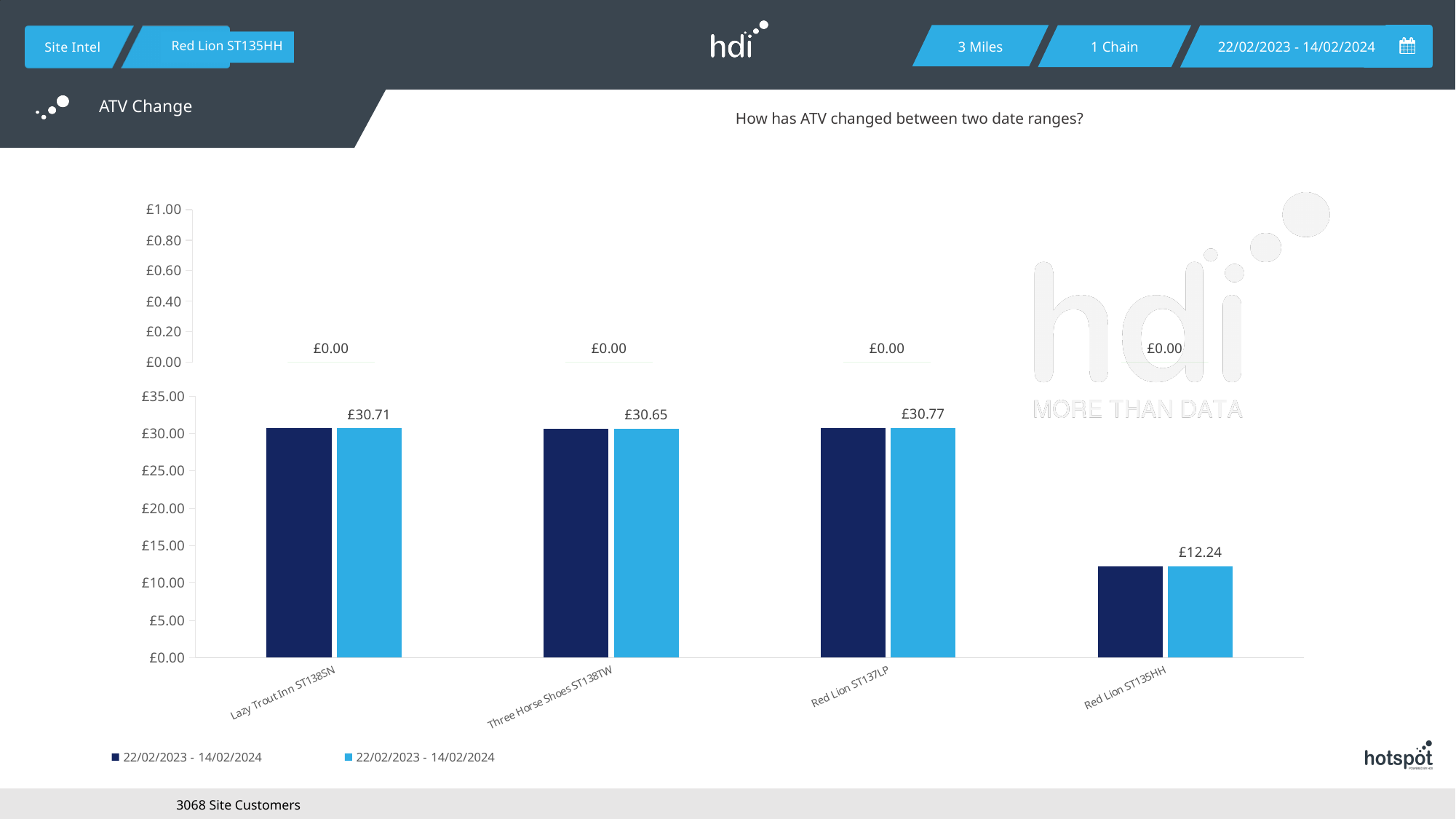
What is the ATV value labelled for Lazy Trout Inn ST138SN? £30.71 Which has a larger labelled ATV value, Lazy Trout Inn ST138SN or Red Lion ST135HH? Lazy Trout Inn ST138SN Which site has the highest labelled ATV value? Red Lion ST137LP How many series does the legend list? 2 What is the ATV value labelled for Red Lion ST135HH? £12.24 What ATV change value is shown above the bars for Red Lion ST135HH in the upper panel? £0.00 What is the ATV value labelled for Red Lion ST137LP? £30.77 What is the ATV value labelled for Three Horse Shoes ST138TW? £30.65 Is the ATV value for Red Lion ST135HH greater or less than £15.00? less How many sites are shown on the x axis of the chart? 4 What is the difference between the labelled ATV values for Red Lion ST137LP and Red Lion ST135HH? £18.53 Which site has the lowest labelled ATV value? Red Lion ST135HH